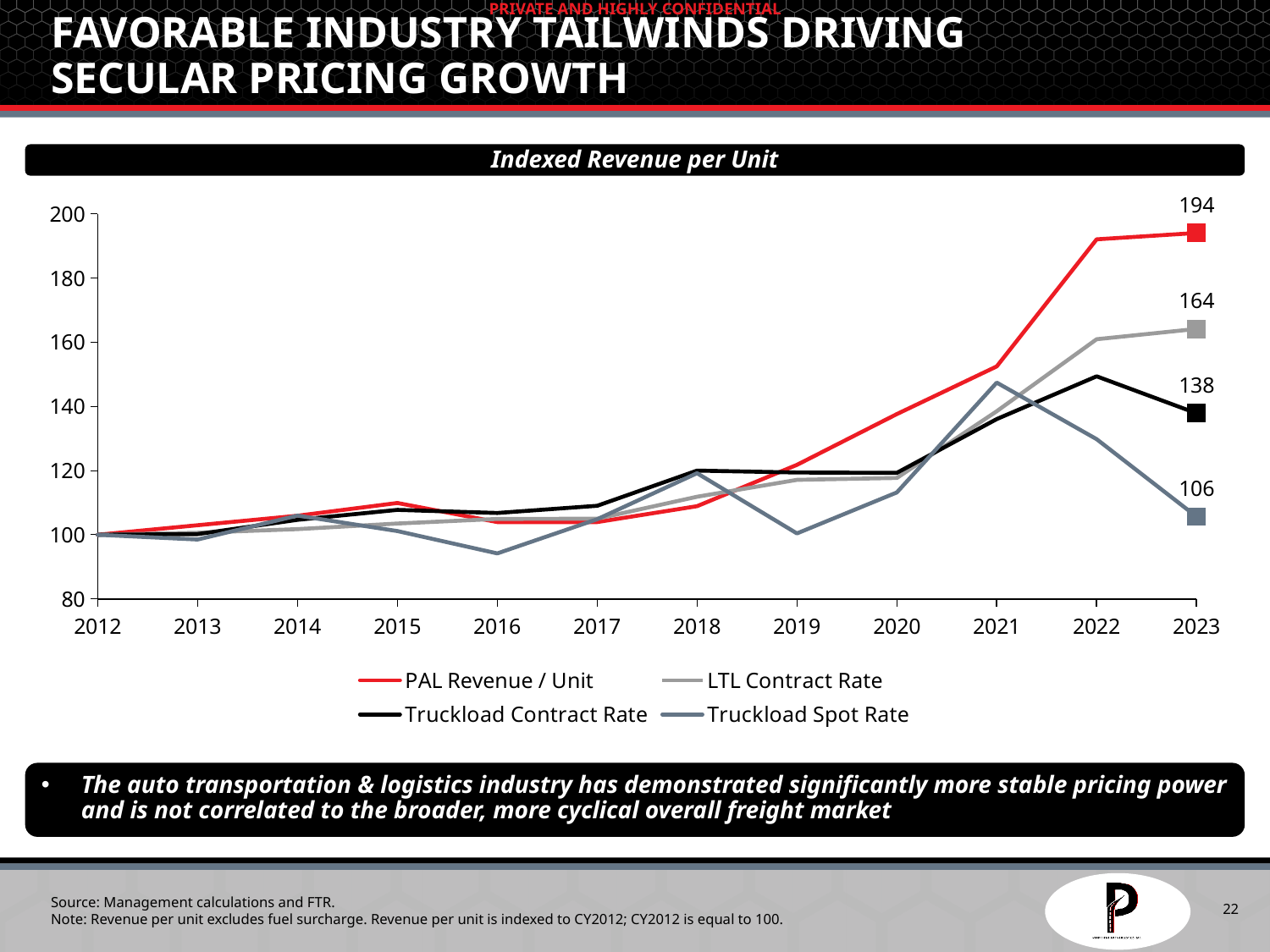
What is the difference between the 2023 values of PAL Revenue / Unit and LTL Contract Rate? 30 Which series has the lowest value in 2023? Truckload Spot Rate How many series does the legend list? 4 What is the 2023 value for Truckload Spot Rate? 106 What is the 2023 value for PAL Revenue / Unit? 194 How many years are shown along the x axis? 12 What is the 2023 value for Truckload Contract Rate? 138 Which series has the highest value in 2023? PAL Revenue / Unit Is the Truckload Spot Rate value for 2021 greater or less than 140? greater What is the title of the chart? Indexed Revenue per Unit What type of chart is shown on the slide? line chart What is the 2023 value for LTL Contract Rate? 164